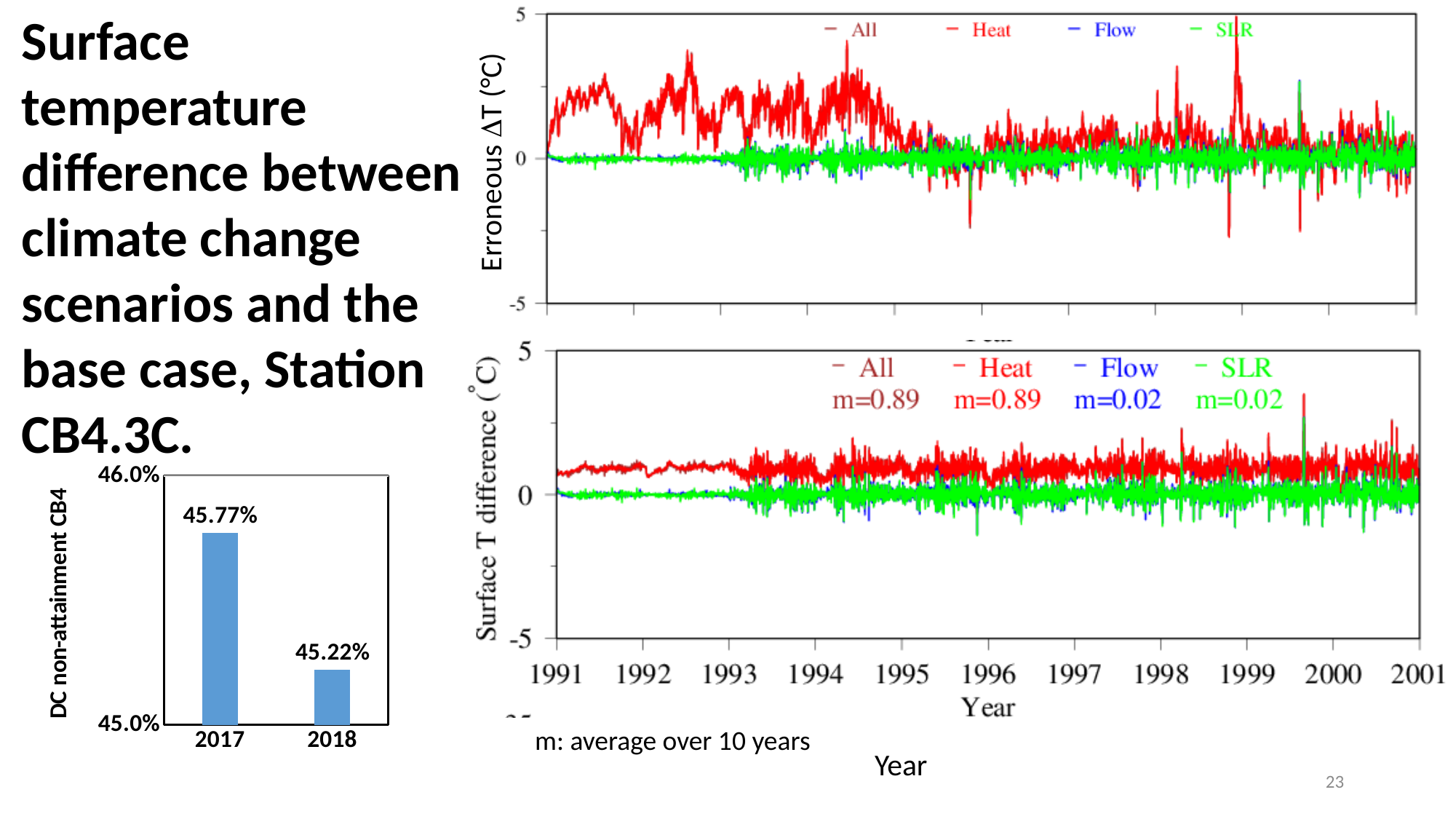
In the lower line chart on the right (Surface T difference), what is the label of the x axis? Year In the bar chart at the bottom left, what is the DC non-attainment CB4 value for 2018? 45.22% In the bar chart at the bottom left, what is the DC non-attainment CB4 value for 2017? 45.77% In the lower line chart on the right (Surface T difference), how many series does the legend list? 4 In the lower line chart on the right (Surface T difference), what is the m value shown for the Heat series? m=0.89 What kind of chart is the one at the bottom left showing DC non-attainment CB4? bar chart In the bar chart at the bottom left, what is the difference between the 2017 and 2018 DC non-attainment CB4 values? 0.55% In the bar chart at the bottom left, does the DC non-attainment CB4 value rise or fall from 2017 to 2018? fall In the bar chart at the bottom left, how many years are shown on the x axis? 2 In the lower line chart on the right (Surface T difference), what is the m value shown for the SLR series? m=0.02 In the bar chart at the bottom left, which year has the higher DC non-attainment CB4 value? 2017 In the bar chart at the bottom left, which year has the lower DC non-attainment CB4 value? 2018